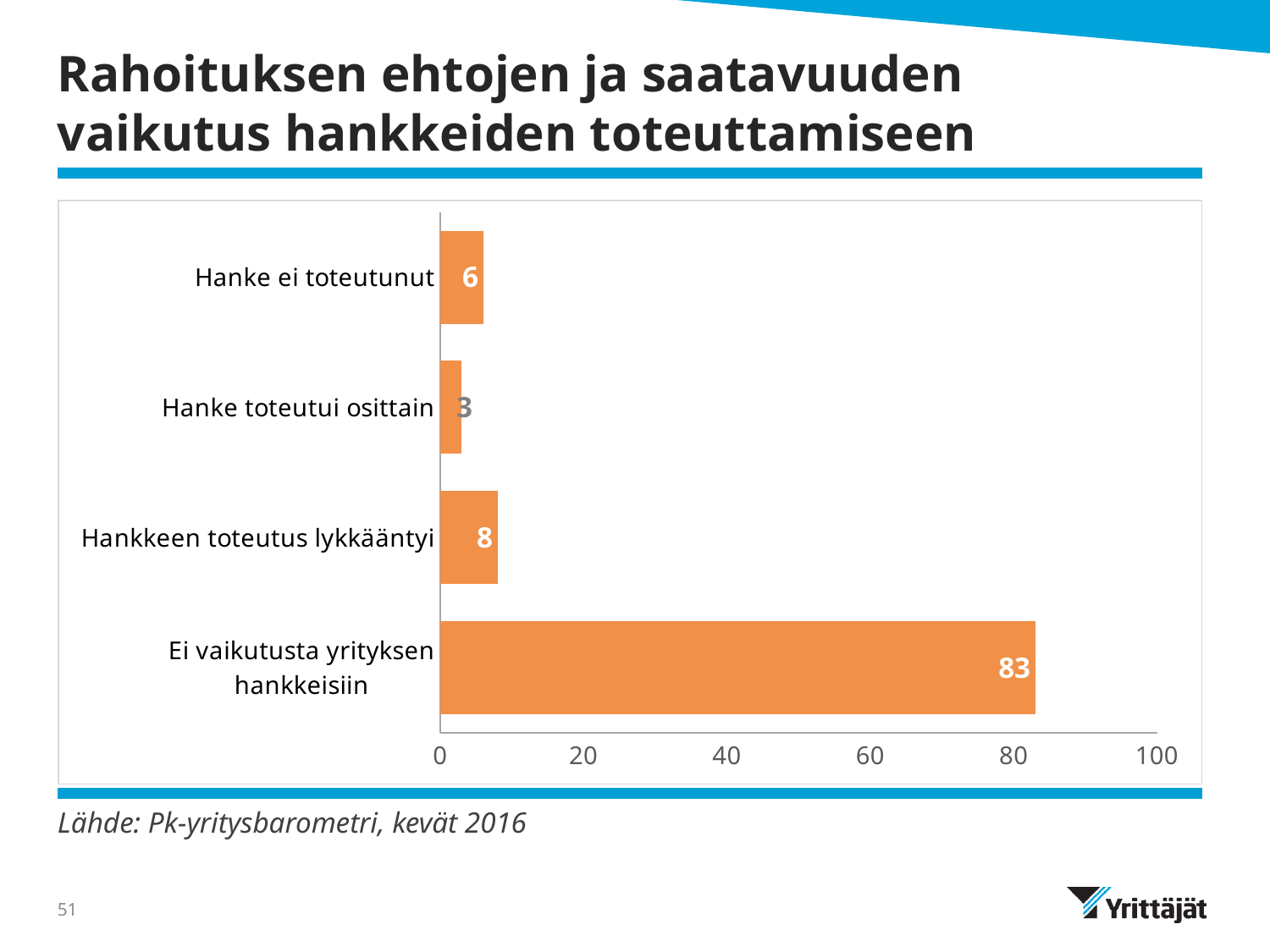
Which is larger, the value for "Hankkeen toteutus lykkääntyi" or the value for "Hanke ei toteutunut"? Hankkeen toteutus lykkääntyi What is the value for "Hanke toteutui osittain"? 3 What kind of chart is shown on the slide? Bar chart What is the value for "Hanke ei toteutunut"? 6 How many categories are shown in the chart? 4 What is the difference between the values for "Ei vaikutusta yrityksen hankkeisiin" and "Hankkeen toteutus lykkääntyi"? 75 What is the value for "Ei vaikutusta yrityksen hankkeisiin"? 83 Which category has the highest value? Ei vaikutusta yrityksen hankkeisiin Is the value for "Ei vaikutusta yrityksen hankkeisiin" greater or less than 80? greater What is the difference between the values for "Hanke ei toteutunut" and "Hanke toteutui osittain"? 3 Which category has the lowest value? Hanke toteutui osittain What is the value for "Hankkeen toteutus lykkääntyi"? 8